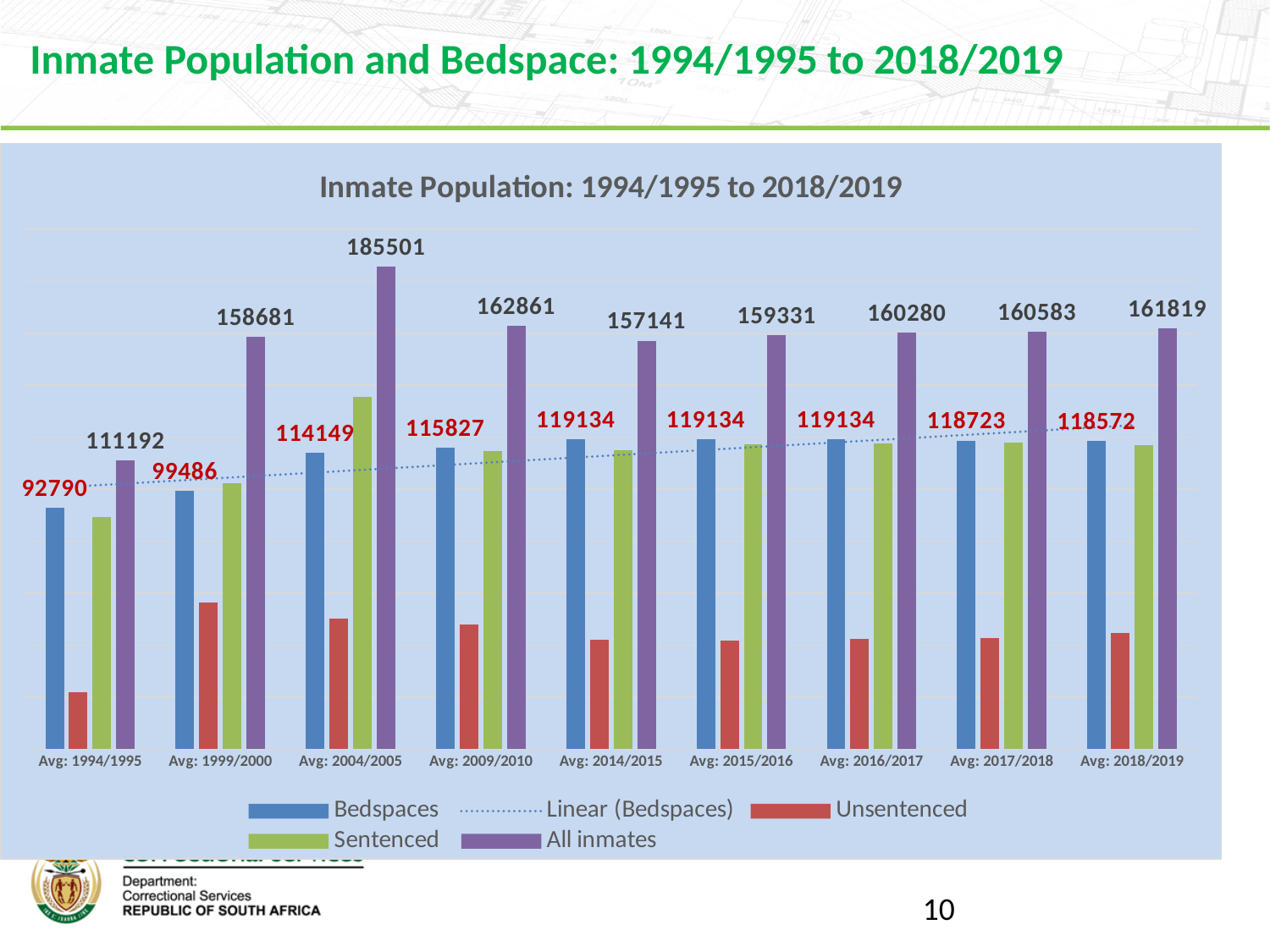
How many categories (periods) are shown on the x axis? 9 What is the title of the chart? Inmate Population: 1994/1995 to 2018/2019 What is the difference between All inmates and Bedspaces in Avg: 2004/2005? 71352 What is the value for Bedspaces in Avg: 1994/1995? 92790 In which period is the Bedspaces value lowest? Avg: 1994/1995 In which period is the All inmates value highest? Avg: 2004/2005 Do the All inmates values rise or fall from Avg: 2014/2015 to Avg: 2018/2019? Rise What is the value for All inmates in Avg: 2018/2019? 161819 Which is larger: the Unsentenced value in Avg: 1999/2000 or in Avg: 2014/2015? Avg: 1999/2000 What is the value for All inmates in Avg: 2004/2005? 185501 How many entries does the legend list? 5 What type of chart is shown on the slide? Bar chart